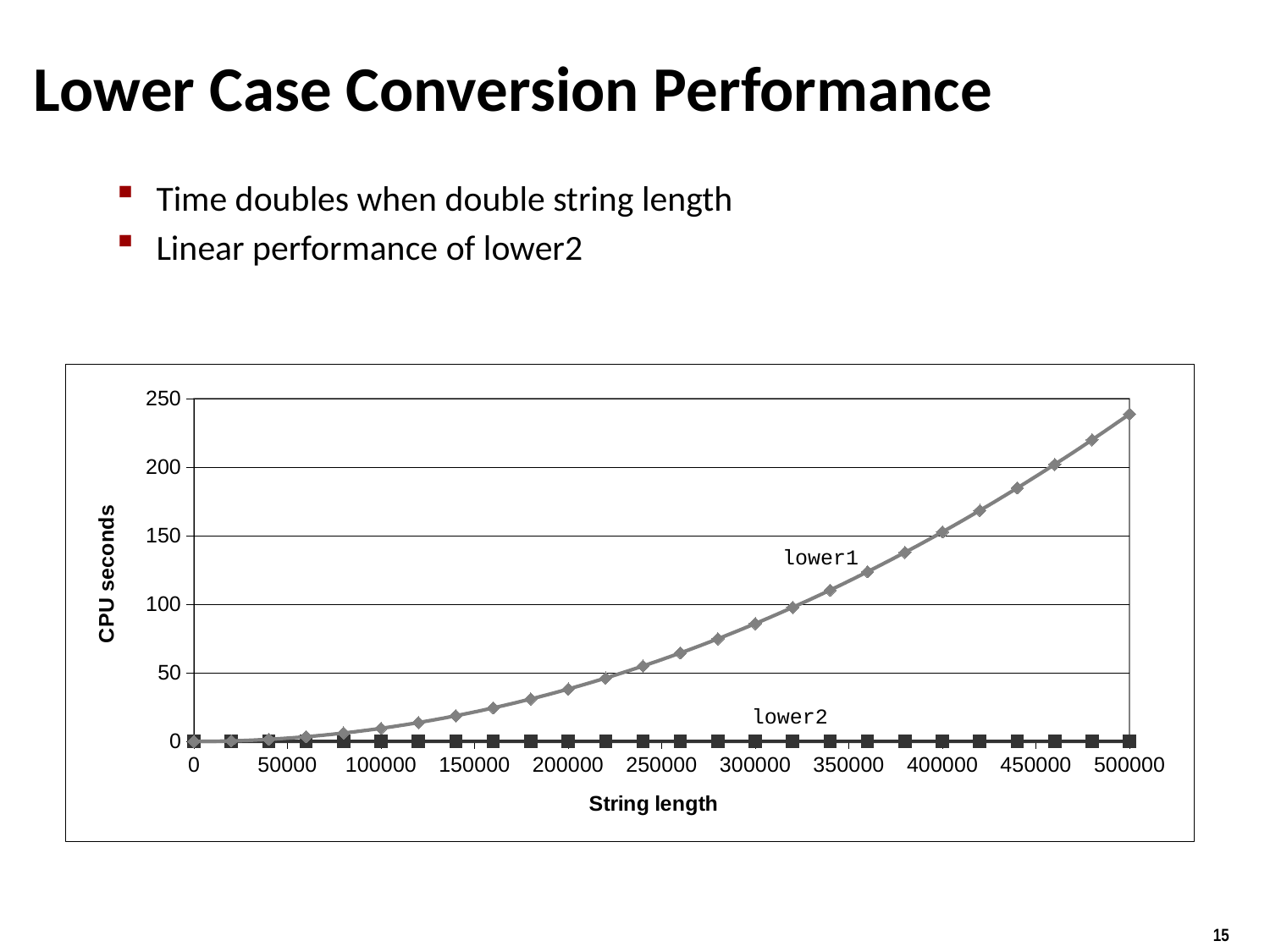
Which series has the larger value at string length 400000, lower1 or lower2? lower1 Does the lower1 series rise or fall as string length increases? rise Is the value for lower2 at string length 500000 greater or less than 50? less What is the label of the y axis? CPU seconds Which series reaches the highest CPU seconds on the chart? lower1 What is the maximum value shown on the y axis? 250 Is the value for lower1 at string length 300000 greater or less than 100? less Is the value for lower1 at string length 200000 greater or less than 50? less What are the names of the two series plotted on the chart? lower1 and lower2 How many series are plotted on the chart? 2 What kind of chart is shown on the slide? line chart